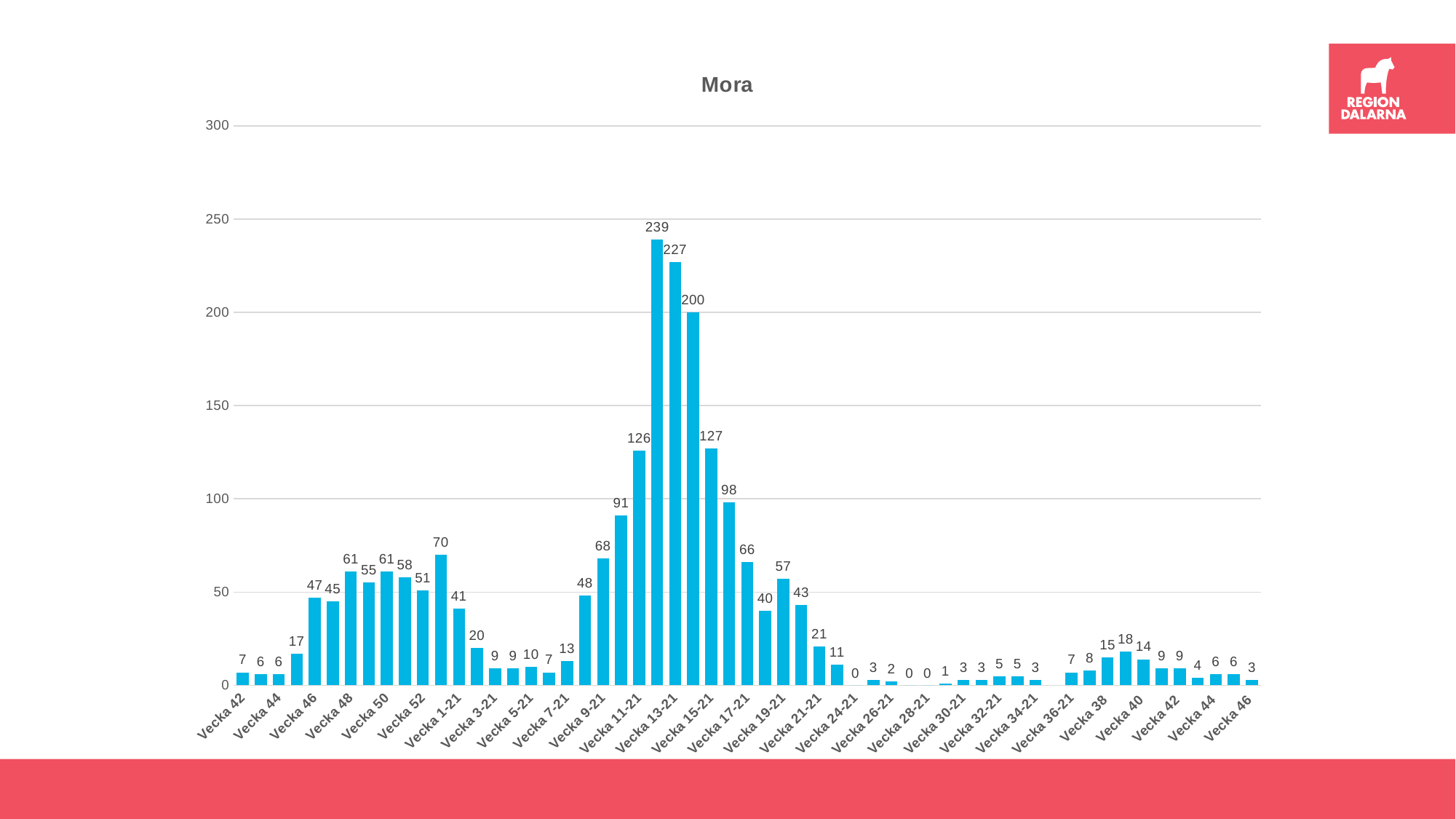
What is the value for Vecka 9-21? 68 What is the value for Vecka 11-21? 126 What is the value for Vecka 48 (on the left side of the chart)? 61 Is the value for Vecka 13-21 greater or less than 200? greater What type of chart is shown on the slide? bar chart Which is larger, the value for Vecka 15-21 or the value for Vecka 17-21? Vecka 15-21 What is the value for Vecka 13-21? 227 What is the highest value shown in the chart? 239 What is the title of the chart? Mora What is the value for Vecka 46 (the first occurrence, on the left side of the chart)? 47 What is the difference between the values for Vecka 13-21 and Vecka 11-21? 101 What is the value for Vecka 52? 51